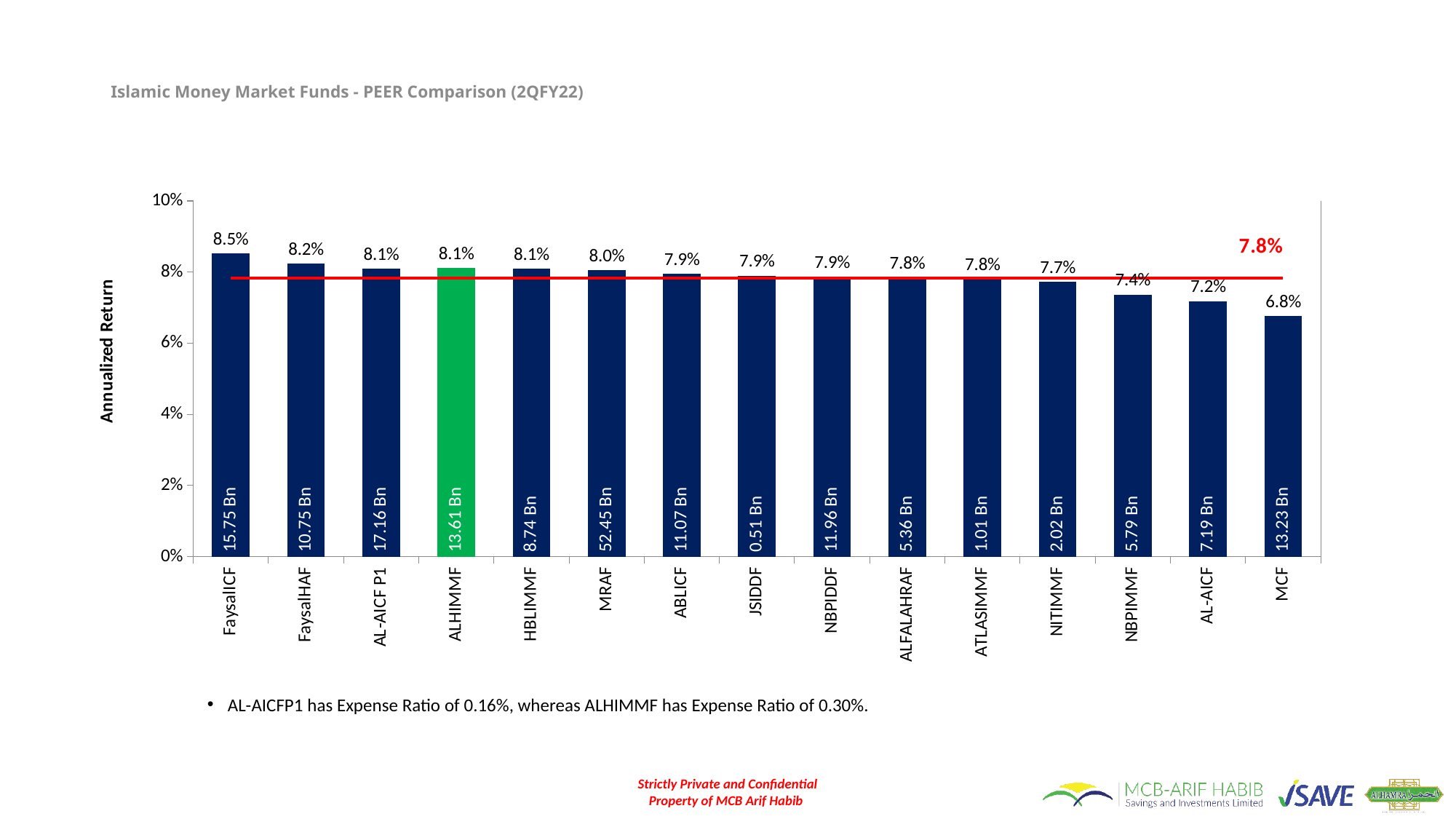
What fund size label is printed inside the ALHIMMF bar? 13.61 Bn What value is labelled on the red horizontal line across the chart? 7.8% What is the annualized return shown for MCF? 6.8% What is the annualized return shown for FaysalICF? 8.5% Which fund has the lowest annualized return? MCF What type of chart is shown on the slide? Bar chart Which fund has the highest annualized return? FaysalICF How many funds are shown on the chart? 15 What is the annualized return shown for NBPIMMF? 7.4% Which has a higher annualized return, FaysalHAF or AL-AICF? FaysalHAF What fund size label is printed inside the MRAF bar? 52.45 Bn What is the difference between the annualized returns of FaysalICF and MCF? 1.7%